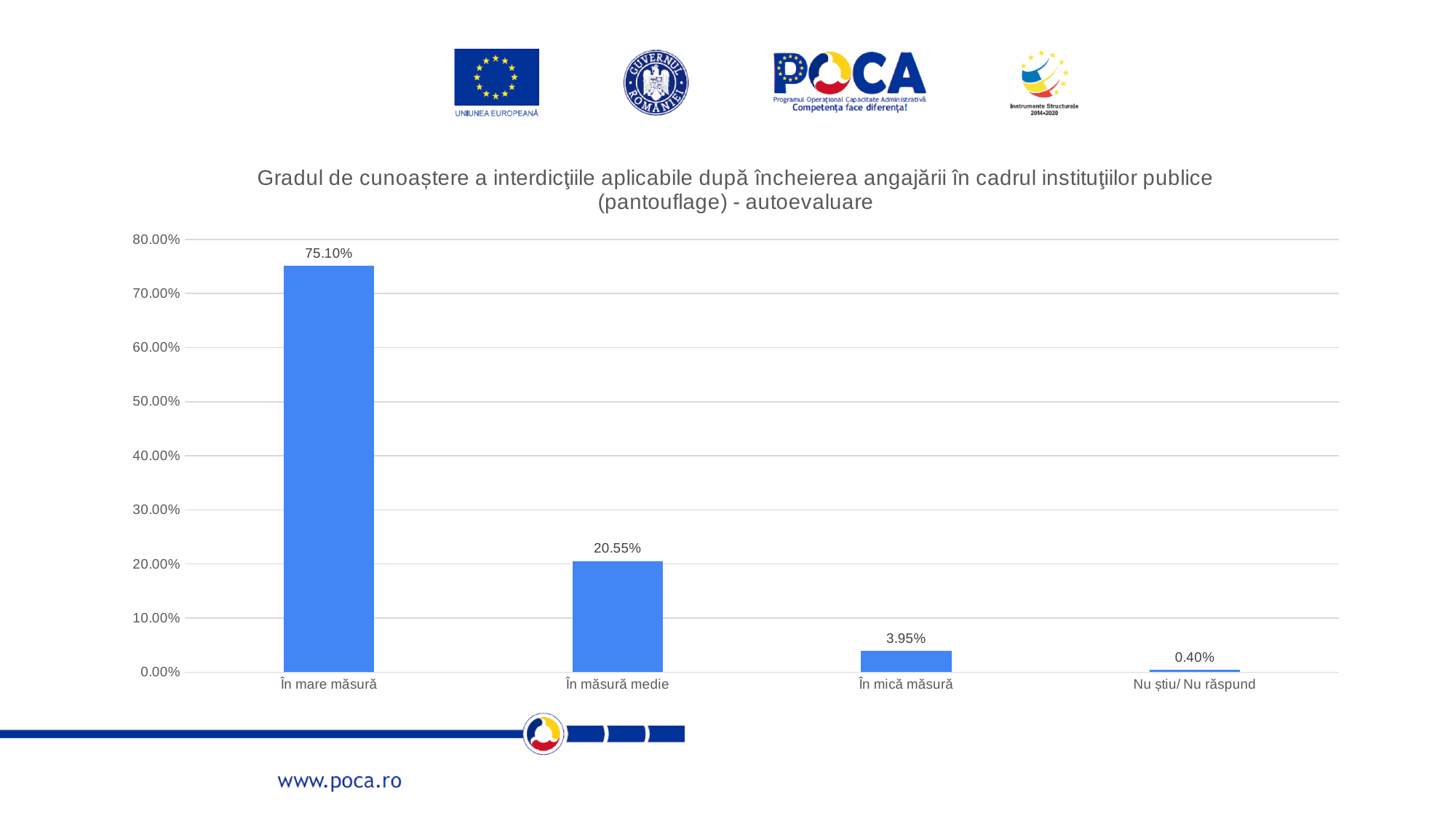
Which is larger, the value for 'În măsură medie' or the value for 'În mică măsură'? În măsură medie What is the difference between the values for 'În mare măsură' and 'În măsură medie'? 54.55% Is the value for 'În mare măsură' greater or less than 70.00%? greater What is the value for 'În mică măsură'? 3.95% What is the value for 'În mare măsură'? 75.10% How many categories are shown on the x axis? 4 Which category has the lowest value? Nu știu/ Nu răspund Do the values rise or fall from left to right along the x axis? fall Which category has the highest value? În mare măsură What is the value for 'În măsură medie'? 20.55% What is the value for 'Nu știu/ Nu răspund'? 0.40% What kind of chart is shown on the slide? bar chart